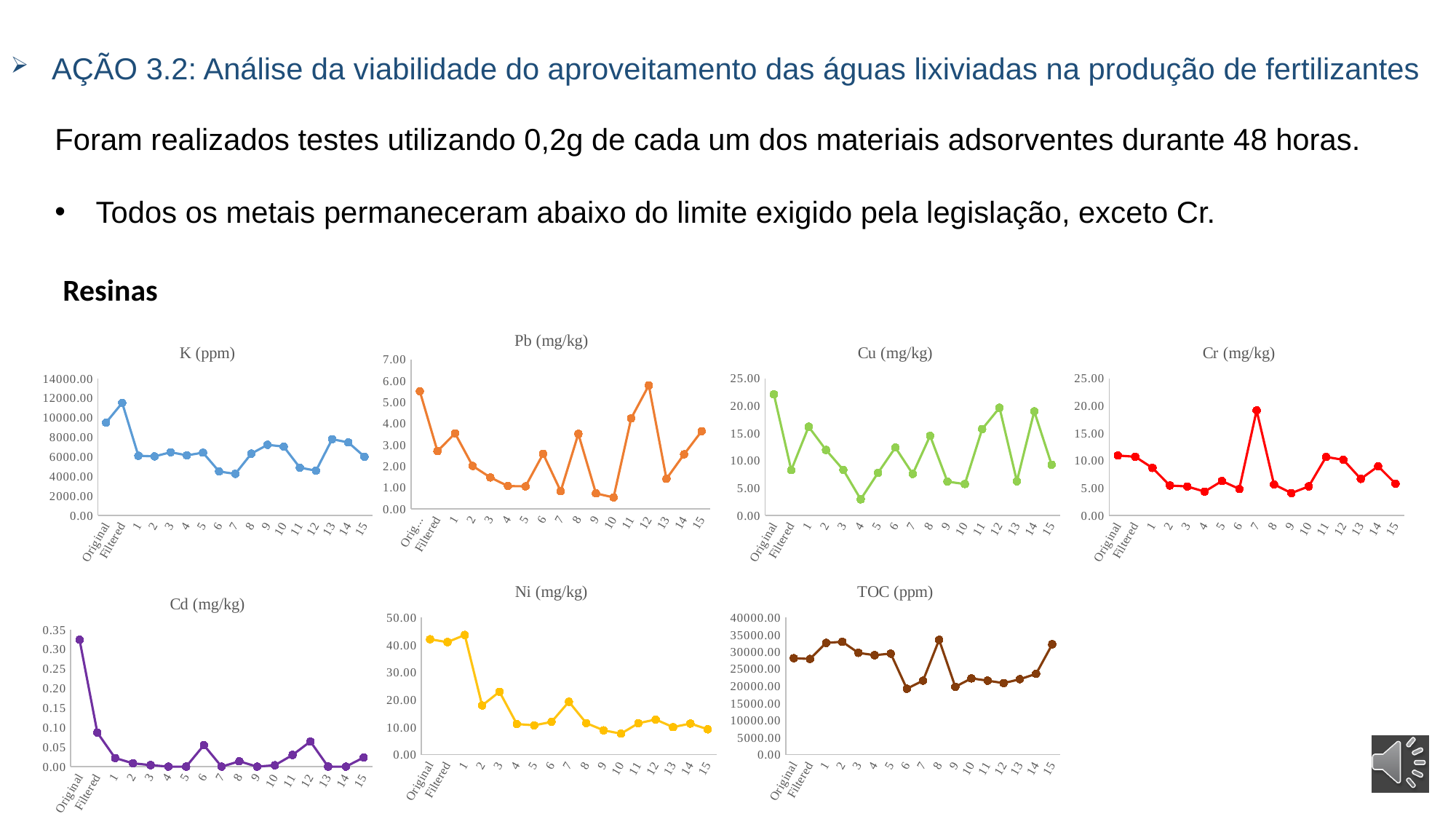
In the Cd (mg/kg) chart, which category has the highest value? Original In the Cu (mg/kg) chart, which is larger, the value for Original or the value for Filtered? Original What type of chart is the K (ppm) chart? line chart In the Cu (mg/kg) chart, how many data points are plotted? 17 How many charts are shown on the slide? 7 In the Cr (mg/kg) chart, which category has the highest value? 7 In the K (ppm) chart, which category has the highest value? Filtered In the Cr (mg/kg) chart, is the value for 7 greater or less than 15.00? greater In the Ni (mg/kg) chart, is the value for Original greater or less than 40.00? greater In the Cd (mg/kg) chart, is the value for Filtered greater or less than 0.10? less In the Cu (mg/kg) chart, which category has the lowest value? 4